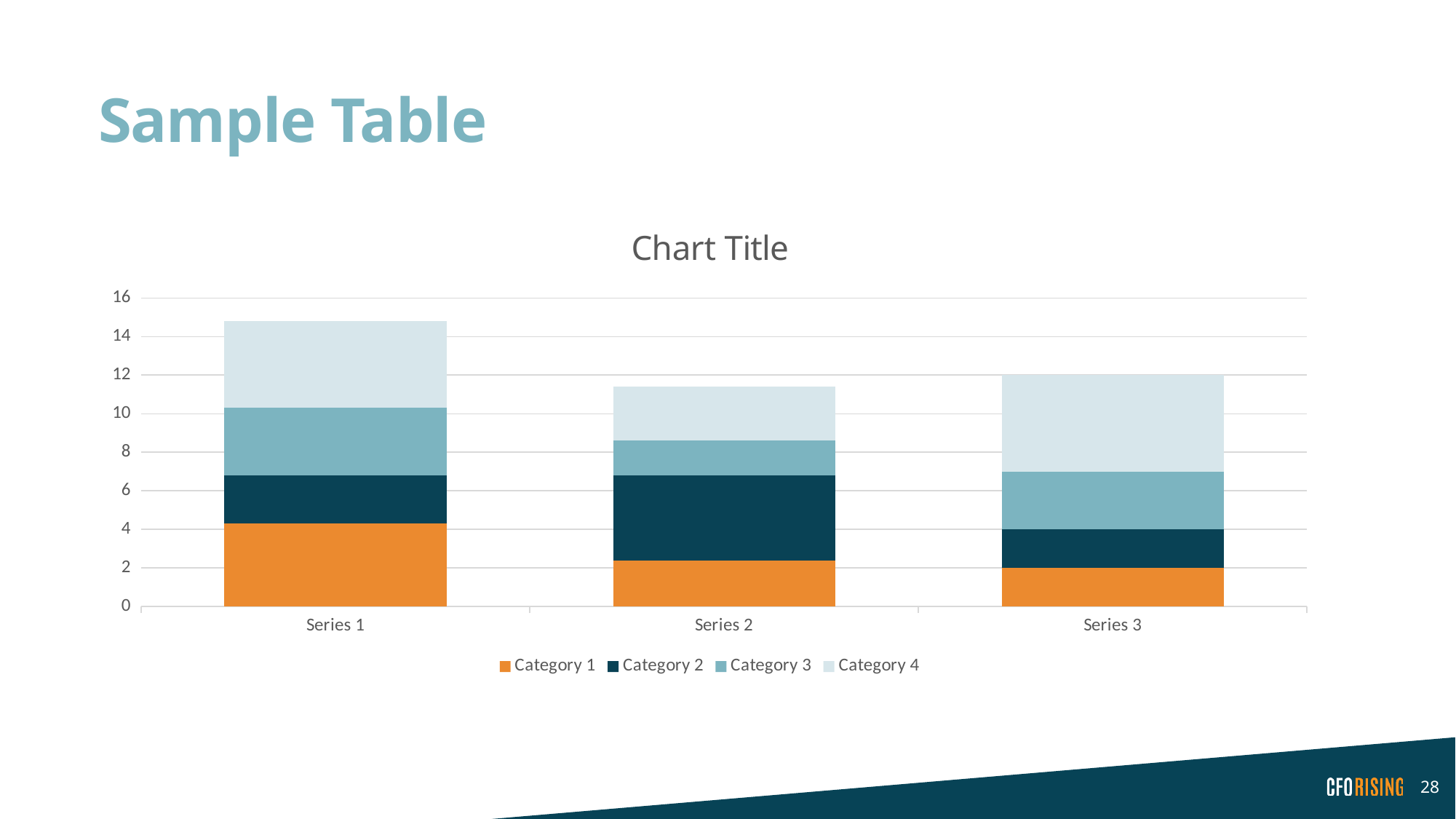
Which series has the shortest stacked bar? Series 2 What is the title of the chart? Chart Title What kind of chart is shown on the slide? Stacked bar chart Is the Category 1 value for Series 2 greater or less than 2? greater How many categories does the legend list? 4 Which stacked bar is taller, Series 1 or Series 3? Series 1 How many series (bars) are shown along the x axis? 3 Is the total height of the Series 1 bar greater or less than 14? greater Is the Category 1 value for Series 1 greater or less than 4? greater Which colour represents Category 1 in the legend? Orange Which series has the tallest stacked bar? Series 1